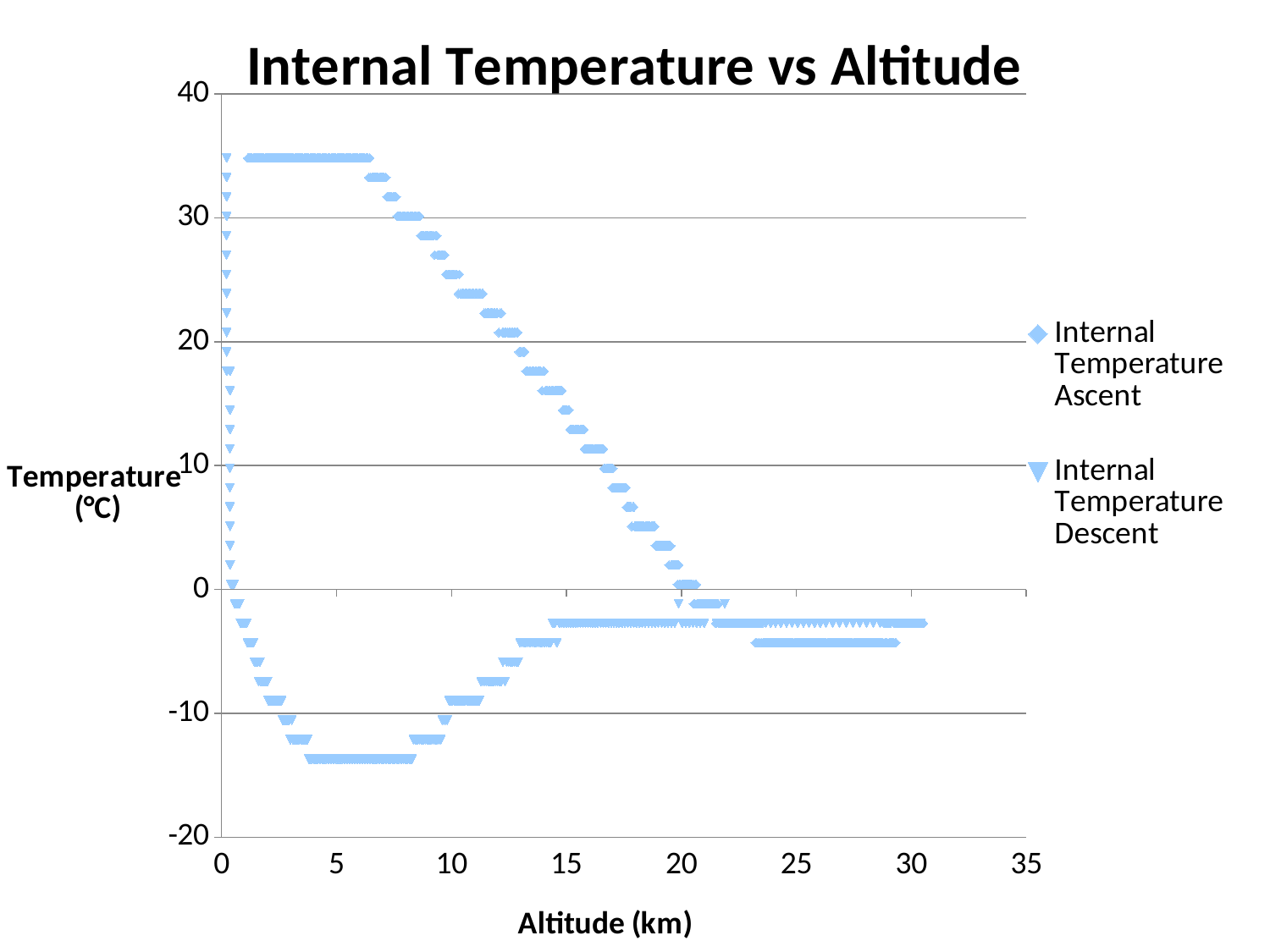
Does the Internal Temperature Ascent series rise or fall as altitude increases from 7 km to 20 km? fall What kind of chart is shown on the slide? Scatter chart Is the Internal Temperature Descent value at 15 km greater or less than -10? greater What is the label of the horizontal axis? Altitude (km) Is the Internal Temperature Descent value at 5 km greater or less than -10? less Does the Internal Temperature Descent series rise or fall as altitude increases from 8 km to 14 km? rise Is the Internal Temperature Ascent value at 15 km greater or less than 10? greater How many series does the legend list? 2 At 10 km altitude, which series has the higher temperature, Internal Temperature Ascent or Internal Temperature Descent? Internal Temperature Ascent What is the title of the chart? Internal Temperature vs Altitude